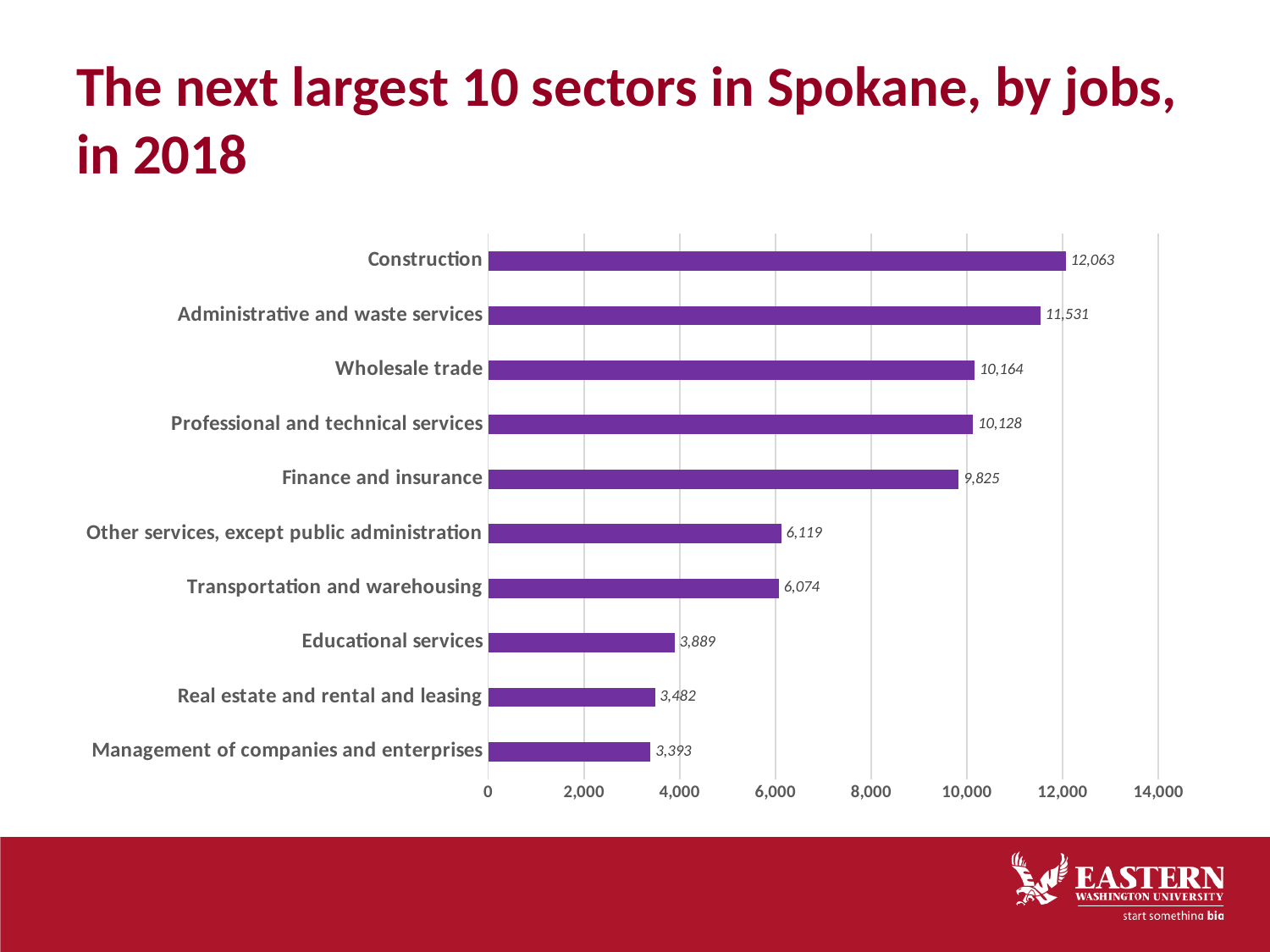
What is the title of the chart on the slide? The next largest 10 sectors in Spokane, by jobs, in 2018 Which has more jobs, Wholesale trade or Finance and insurance? Wholesale trade Is the value for Real estate and rental and leasing greater or less than 4,000? less How many jobs does the Construction sector have? 12,063 Which sector has the lowest number of jobs? Management of companies and enterprises What kind of chart is shown on the slide? Bar chart What is the difference between Other services, except public administration and Transportation and warehousing? 45 What is the difference in jobs between Construction and Administrative and waste services? 532 Which sector has the highest number of jobs? Construction What is the value for Finance and insurance? 9,825 What is the value for Educational services? 3,889 How many sectors are shown in the chart? 10